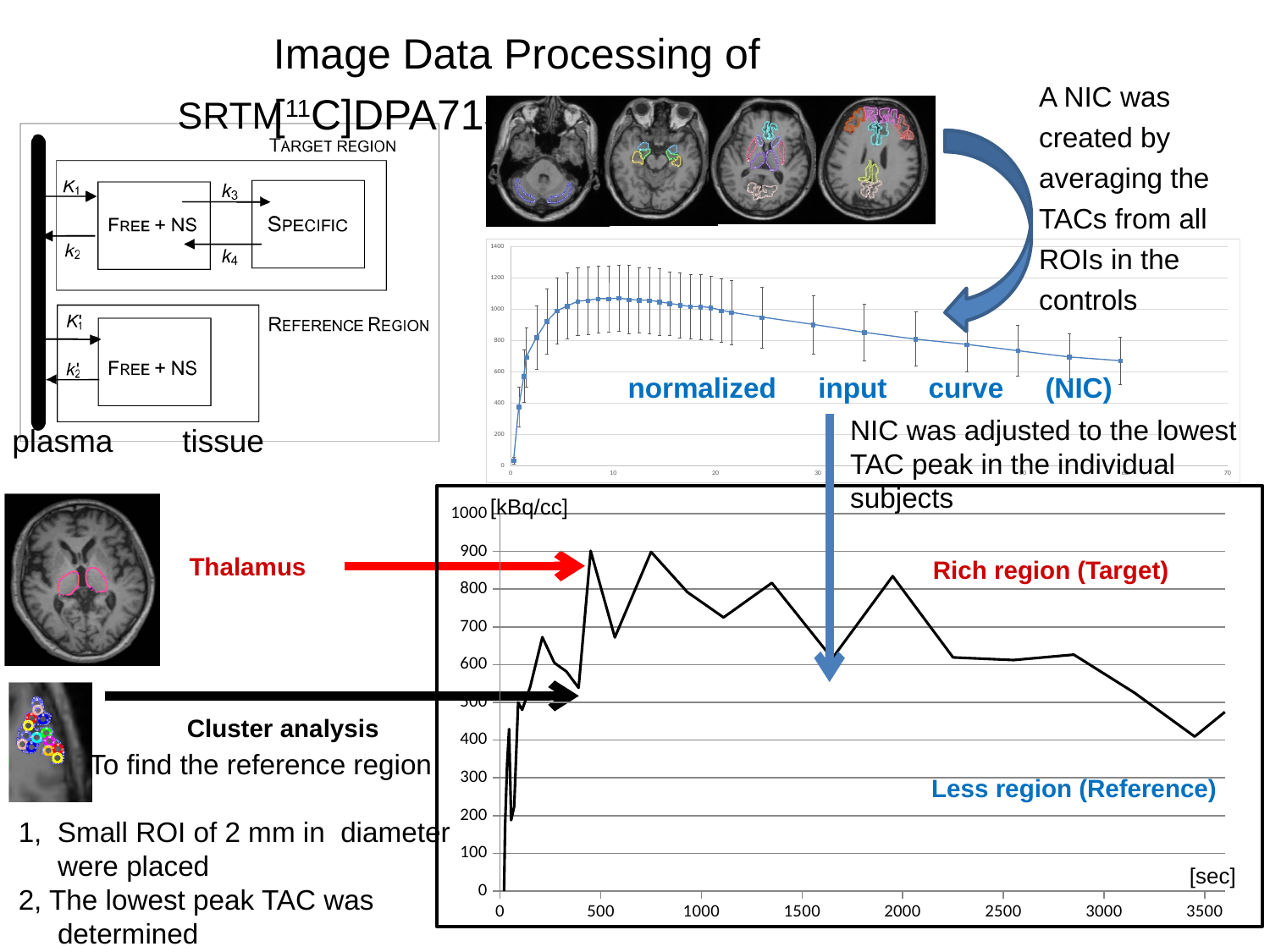
On the bottom chart, what unit is shown on the horizontal axis? [sec] On the bottom chart, is the value at 2000 sec greater or less than 700? greater What kind of chart is the bottom chart with the [kBq/cc] axis? line chart On the bottom chart, what is the largest tick value shown on the horizontal axis? 3500 On the normalized input curve (NIC) chart, is the value at x = 10 greater or less than 1000? greater On the bottom chart, what is the highest value shown on the vertical axis? 1000 On the bottom chart, is the value at 3000 sec greater or less than 700? less On the bottom chart, what unit is shown on the vertical axis? [kBq/cc] On the normalized input curve (NIC) chart, do the values rise or fall between x = 20 and x = 60? fall On the bottom chart, do the values generally rise or fall between 2000 sec and 3500 sec? fall